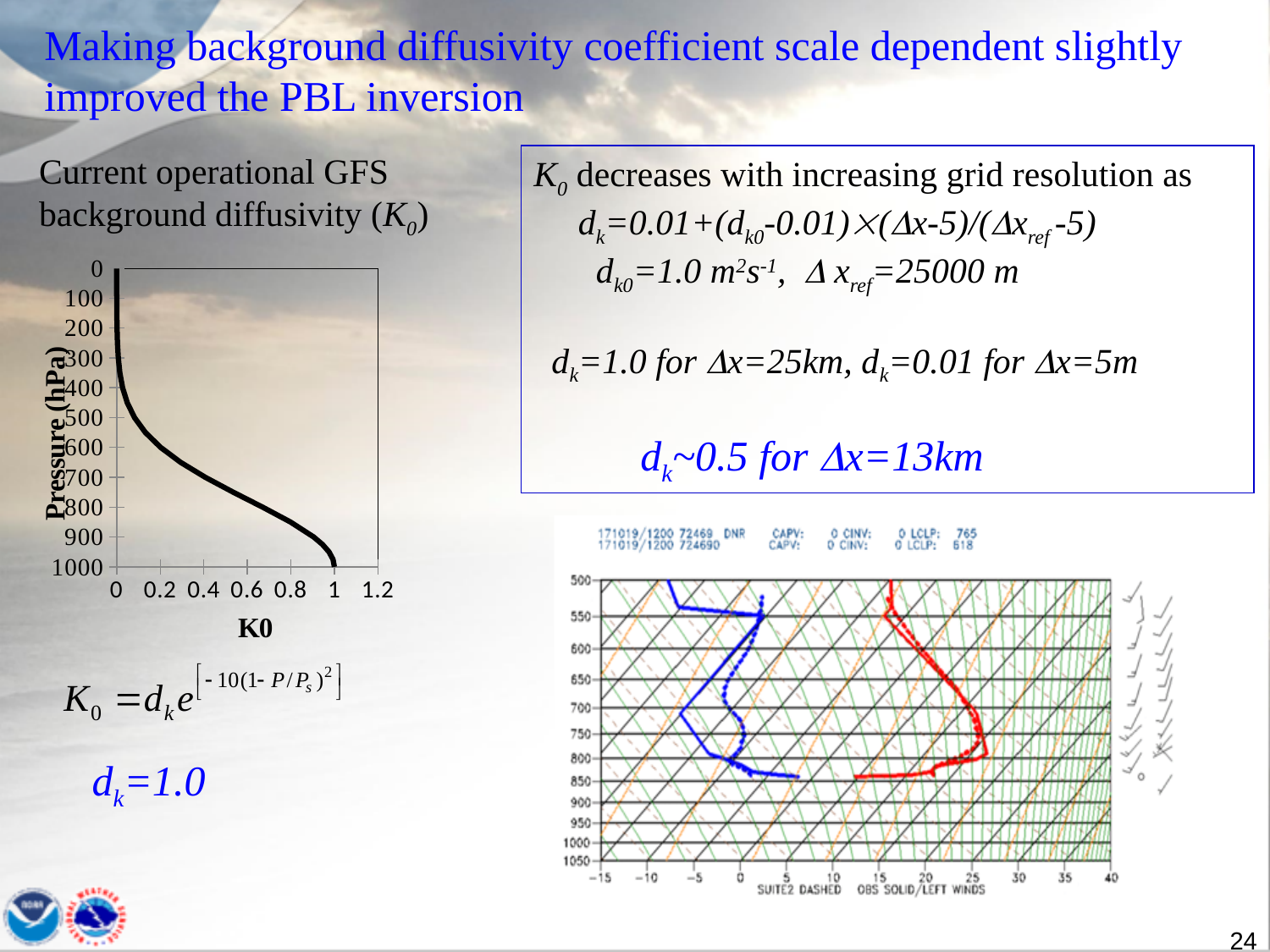
On the left chart, does K0 increase or decrease as pressure increases from 0 to 1000 hPa? increase On the left chart, is the value of K0 at 700 hPa larger or smaller than the value at 900 hPa? smaller On the left chart, is the value of K0 at 500 hPa greater or less than 0.2? less On the skew-T diagram at the bottom right, what is the highest pressure level labelled on the vertical axis? 1050 On the left chart, what is the value of K0 at 1000 hPa? 1 On the left chart, what is the label of the horizontal axis? K0 On the skew-T diagram at the bottom right, what is the lowest pressure level labelled on the vertical axis? 500 On the left chart, is the value of K0 at 300 hPa greater or less than 0.2? less What kind of chart is the Pressure (hPa) versus K0 chart on the left of the slide? line chart On the left chart, is the value of K0 at 900 hPa greater or less than 0.8? greater On the left chart, what is the label of the vertical axis? Pressure (hPa)